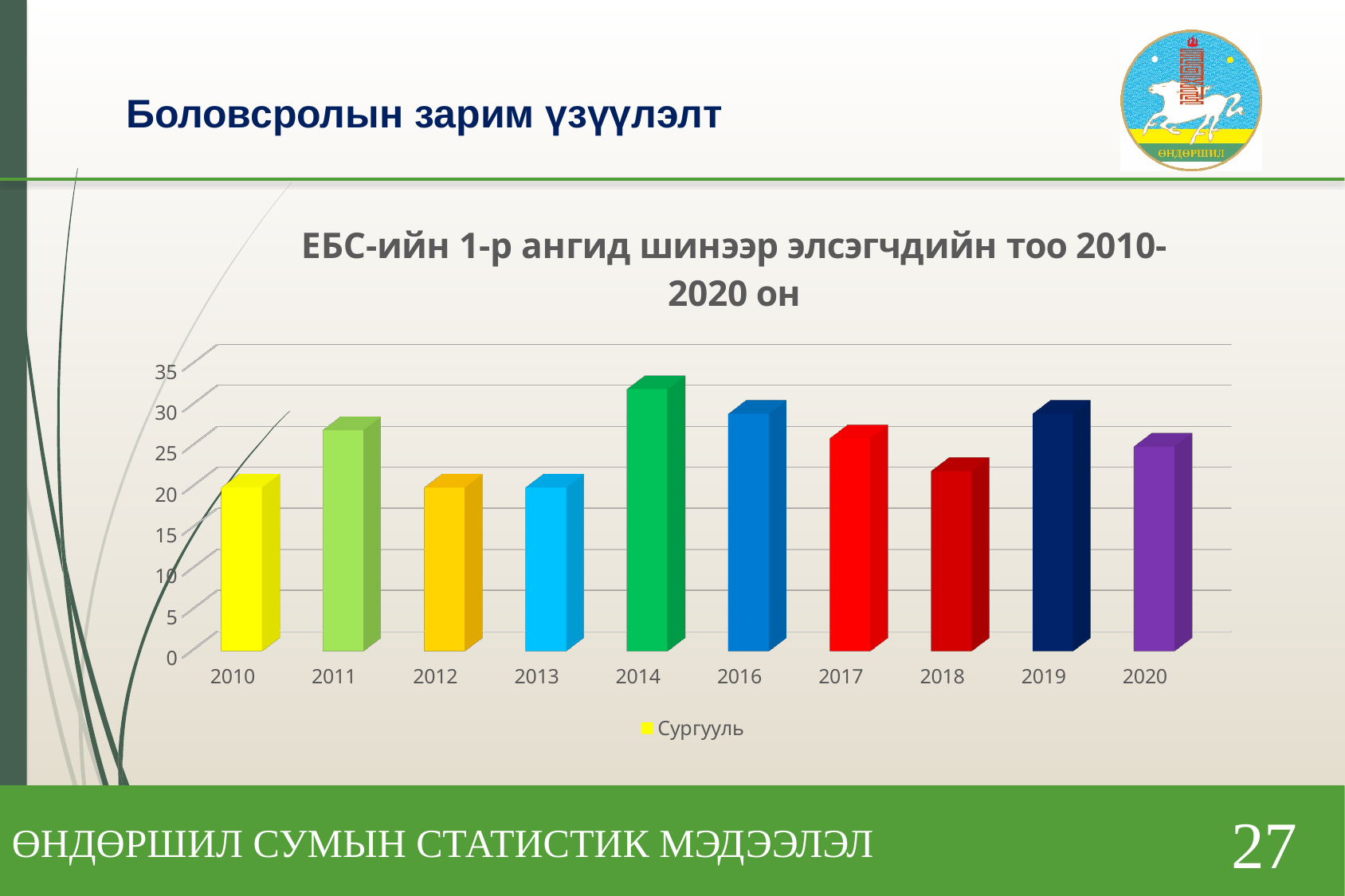
What kind of chart is shown on the slide? bar chart Is the value for 2011 greater or less than 25? greater Is the value for 2013 greater or less than 25? less How many series does the chart legend list? 1 Is the value for 2017 greater or less than 30? less Which year has the larger value, 2014 or 2018? 2014 Which year has the highest number of new first-grade enrolments in the chart? 2014 How many years (categories) are shown on the x axis of the chart? 10 What is the name of the series shown in the chart legend? Сургууль Which year has the larger value, 2010 or 2011? 2011